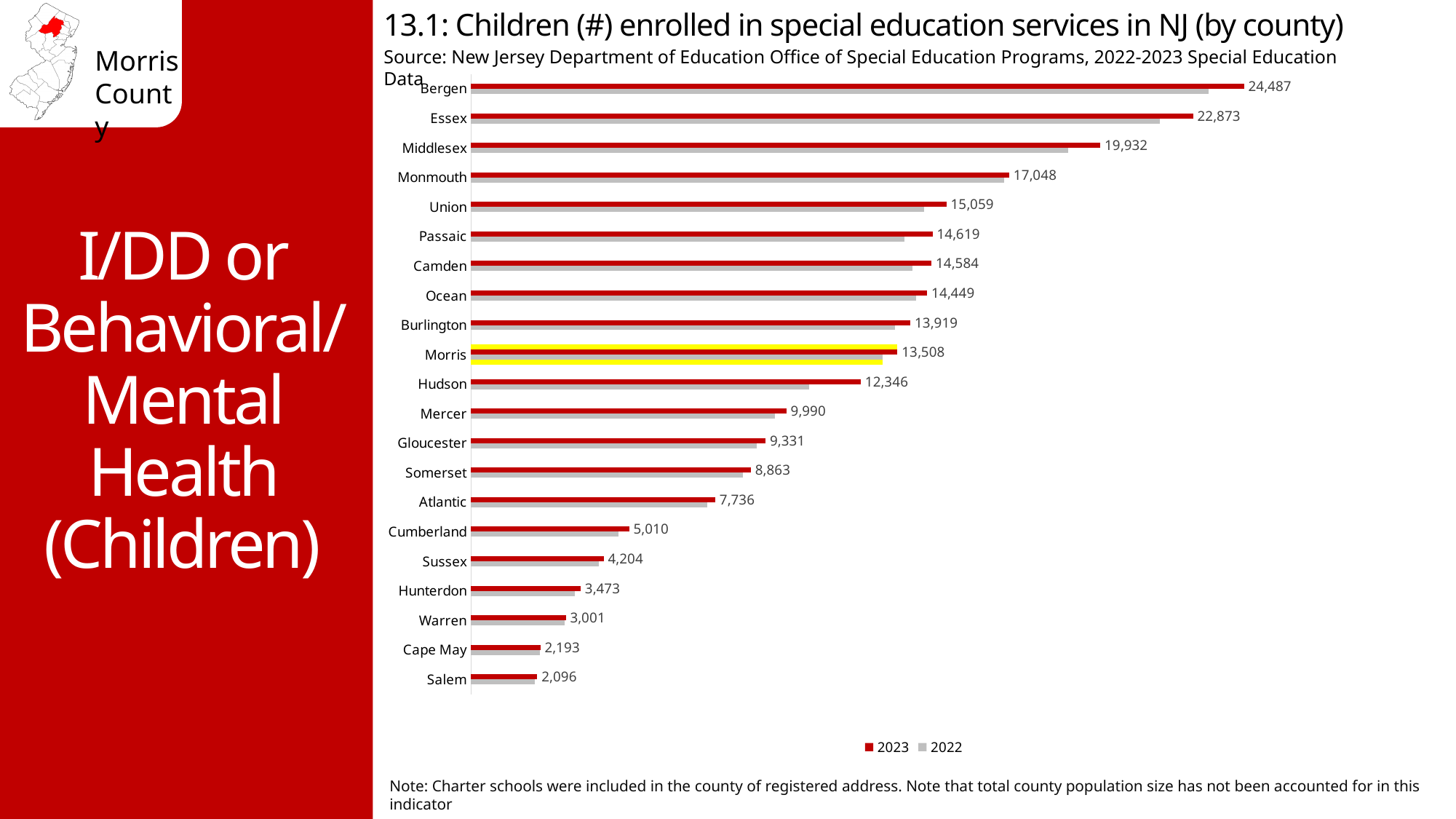
What is the 2023 value for Bergen County? 24,487 What is the difference between the 2023 values for Bergen and Essex? 1,614 Which has a larger 2023 value, Morris or Burlington? Burlington How many series does the legend list? 2 How many counties are shown in the chart? 21 What is the 2023 value for Morris County? 13,508 Which county has the highest number of children enrolled in special education services in 2023? Bergen Which county has the lowest number of children enrolled in special education services in 2023? Salem What is the difference between the 2023 values for Morris and Hudson? 1,162 Which has a larger 2023 value, Mercer or Somerset? Mercer What is the 2023 value for Salem County? 2,096 What kind of chart is shown on the slide? Bar chart